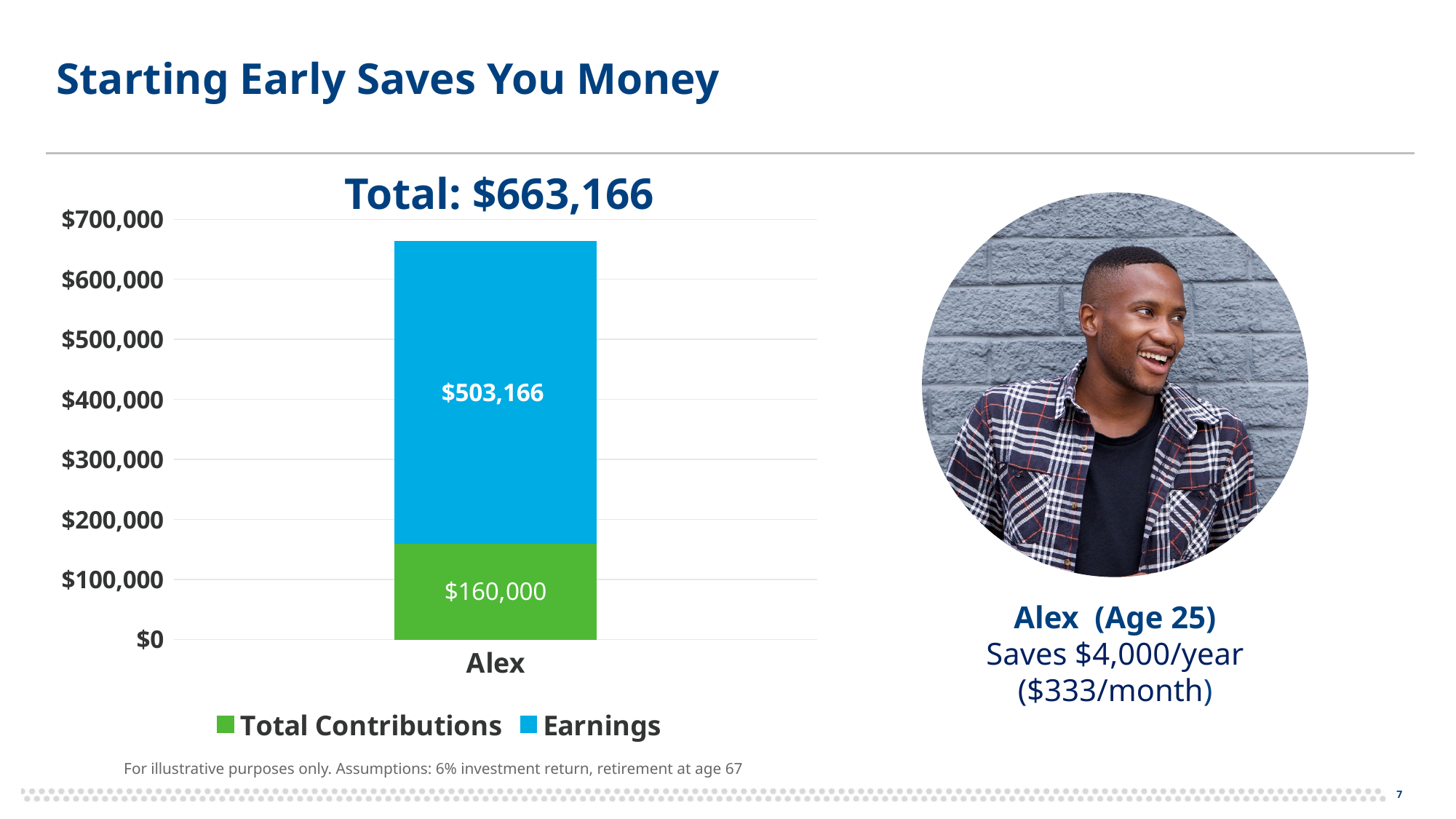
What kind of chart is shown on the slide? Stacked bar chart What is the total of the stacked bar for Alex? $663,166 What colour represents Earnings in the chart? Blue What is the value of Total Contributions for Alex? $160,000 What is the difference between Earnings and Total Contributions for Alex? $343,166 How many categories are shown on the x axis? 1 Is the Total Contributions value for Alex greater or less than $200,000? less Which is larger for Alex, Earnings or Total Contributions? Earnings What is the value of Earnings for Alex? $503,166 How many series does the legend list? 2 Which series has the smaller value for Alex? Total Contributions Is the total of the bar for Alex greater or less than $600,000? greater